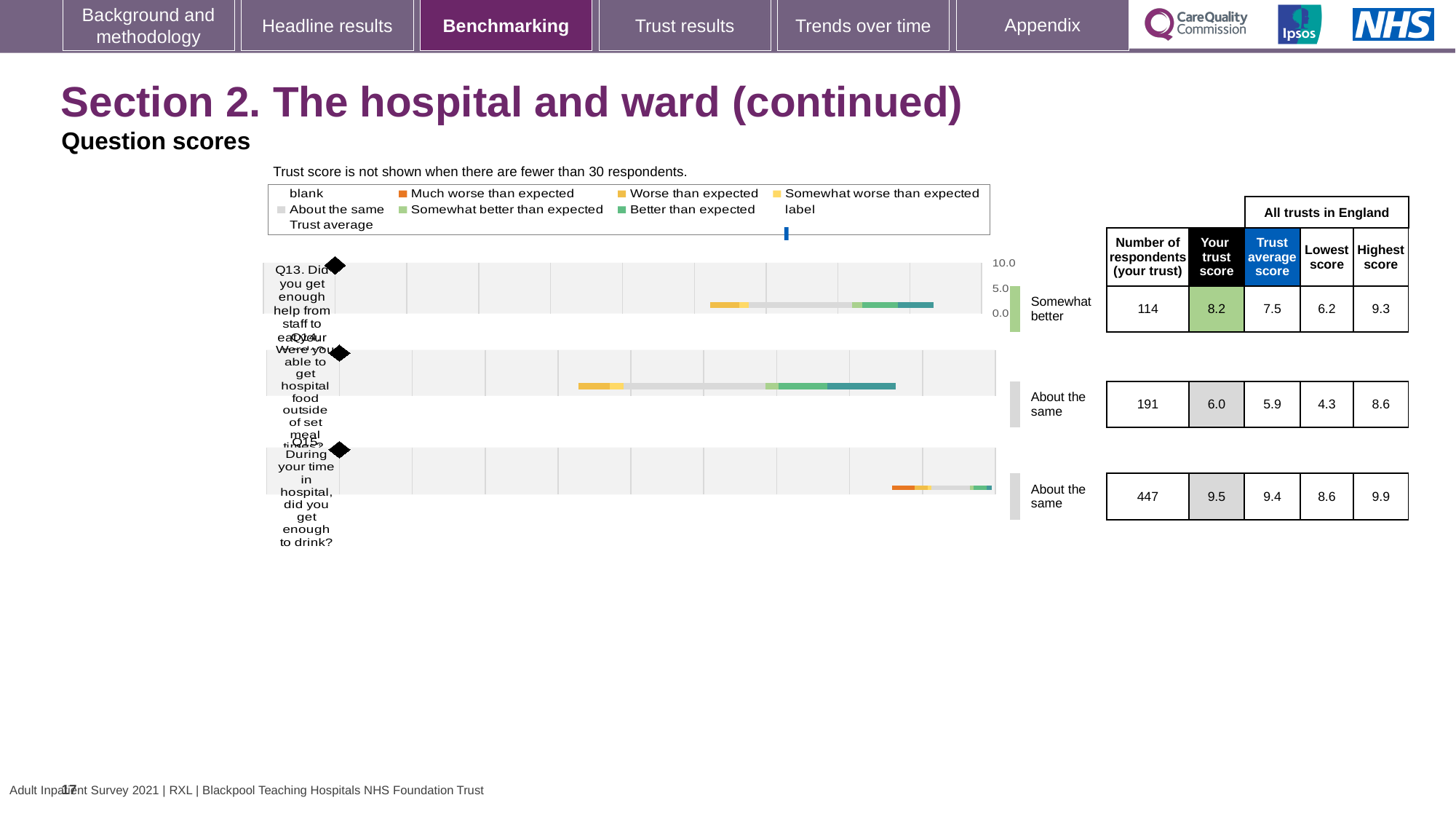
What benchmark category is shown for Q13? Somewhat better Which question has the lowest trust score? Q14 What kind of chart is used to show the question scores for Q13, Q14 and Q15? bar chart Which question has the highest trust score? Q15 What is the trust score for Q15 (During your time in hospital, did you get enough to drink?)? 9.5 What is the trust average score across all trusts in England for Q14? 5.9 What is the difference between the trust score and the trust average score for Q13? 0.7 How many questions are plotted in the chart? 3 What is the trust score for Q14 (Were you able to get hospital food outside of set meal times?)? 6.0 What is the trust score for Q13 (Did you get enough help from staff to eat your meals?)? 8.2 Is the trust score for Q13 higher or lower than the trust score for Q14? higher How many respondents answered Q15 for this trust? 447